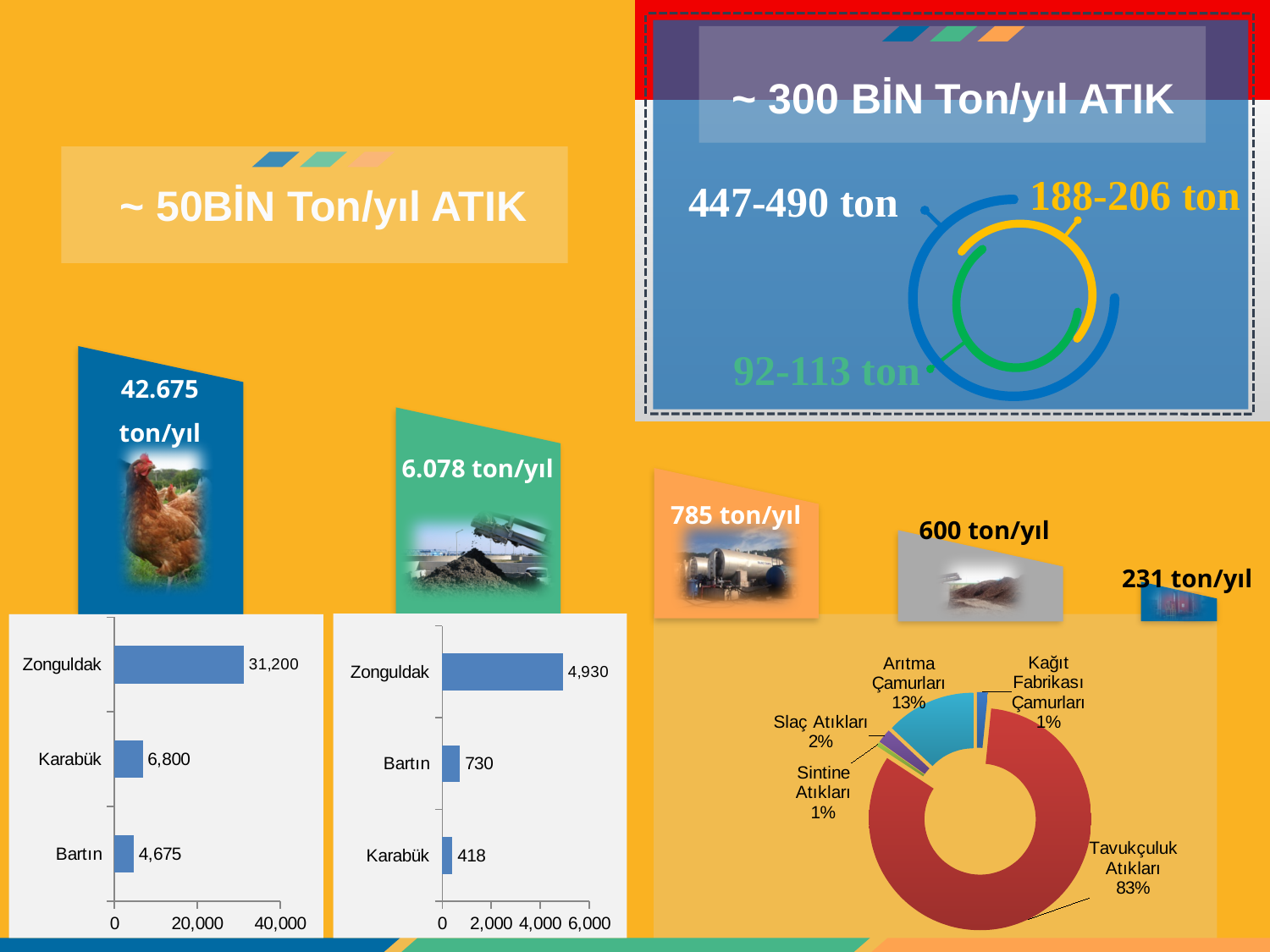
In the middle bar chart, which is larger, the value for Bartın or the value for Karabük? Bartın In the left bar chart, what is the value for Karabük? 6,800 In the left bar chart, what is the value for Zonguldak? 31,200 What kind of chart is the chart at the bottom right of the slide? Doughnut chart How many categories does the middle bar chart show? 3 In the doughnut chart on the right, what share does Tavukçuluk Atıkları have? 83% In the middle bar chart, what is the difference between the values for Bartın and Karabük? 312 In the left bar chart, what is the difference between the values for Zonguldak and Karabük? 24,400 In the middle bar chart, which category has the highest value? Zonguldak In the left bar chart, which category has the lowest value? Bartın In the doughnut chart on the right, what share does Arıtma Çamurları have? 13% In the middle bar chart, what is the value for Bartın? 730